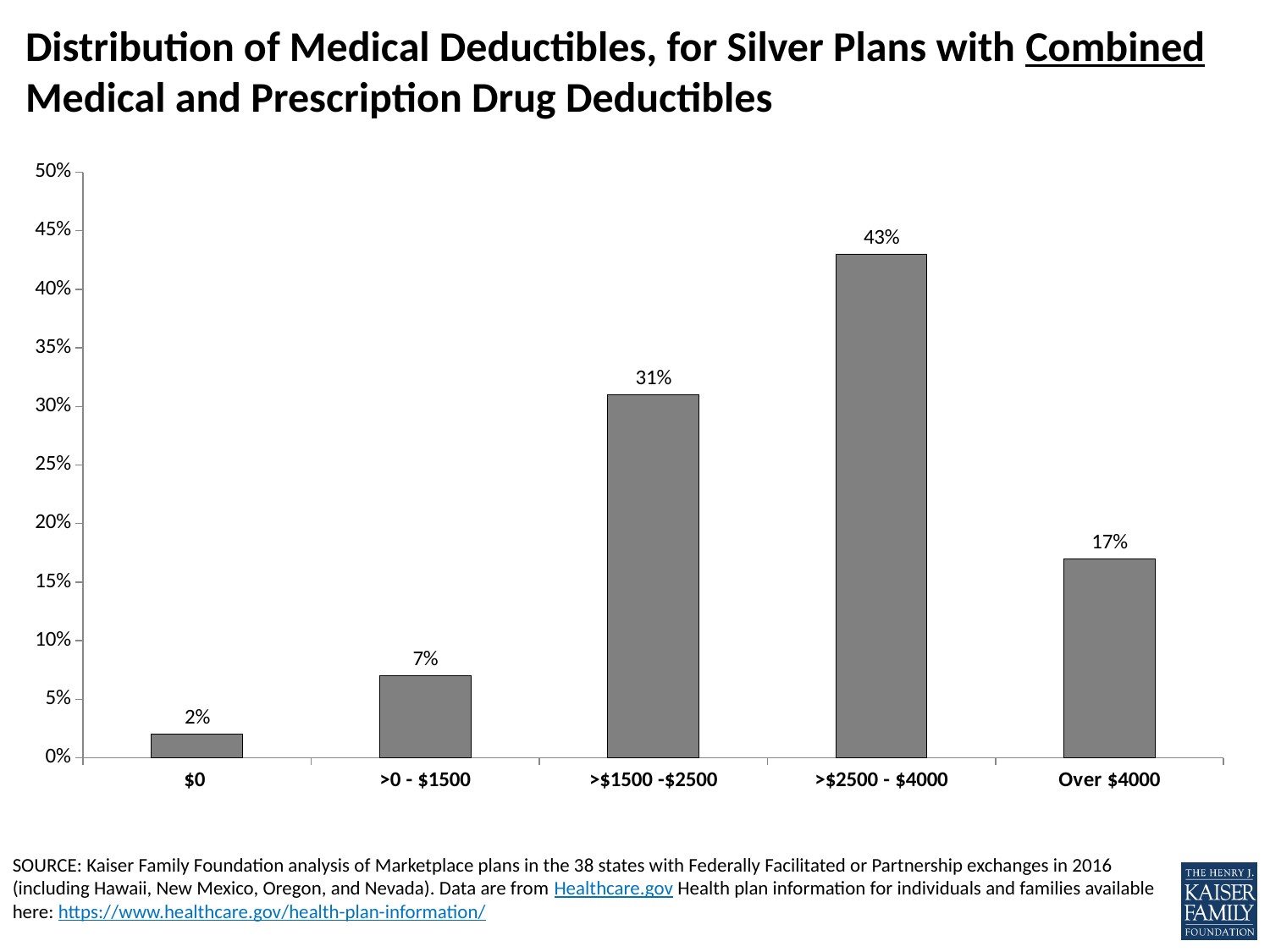
Which deductible category has the highest percentage of plans? >$2500 - $4000 What share of plans fall in the Over $4000 category? 17% What kind of chart is shown on the slide? Bar chart What is the value for the >$2500 - $4000 deductible category? 43% Which is larger: the value for >0 - $1500 or the value for Over $4000? Over $4000 What is the combined percentage of plans in the $0 and >0 - $1500 categories? 9% What percentage of silver plans with combined deductibles have a medical deductible of $0? 2% How many deductible categories are shown on the x axis? 5 Is the value for >$1500 -$2500 greater or less than 30%? greater What is the difference in percentage points between the >$2500 - $4000 and >$1500 -$2500 categories? 12 Which deductible category has the lowest percentage of plans? $0 What is the maximum value shown on the vertical axis? 50%